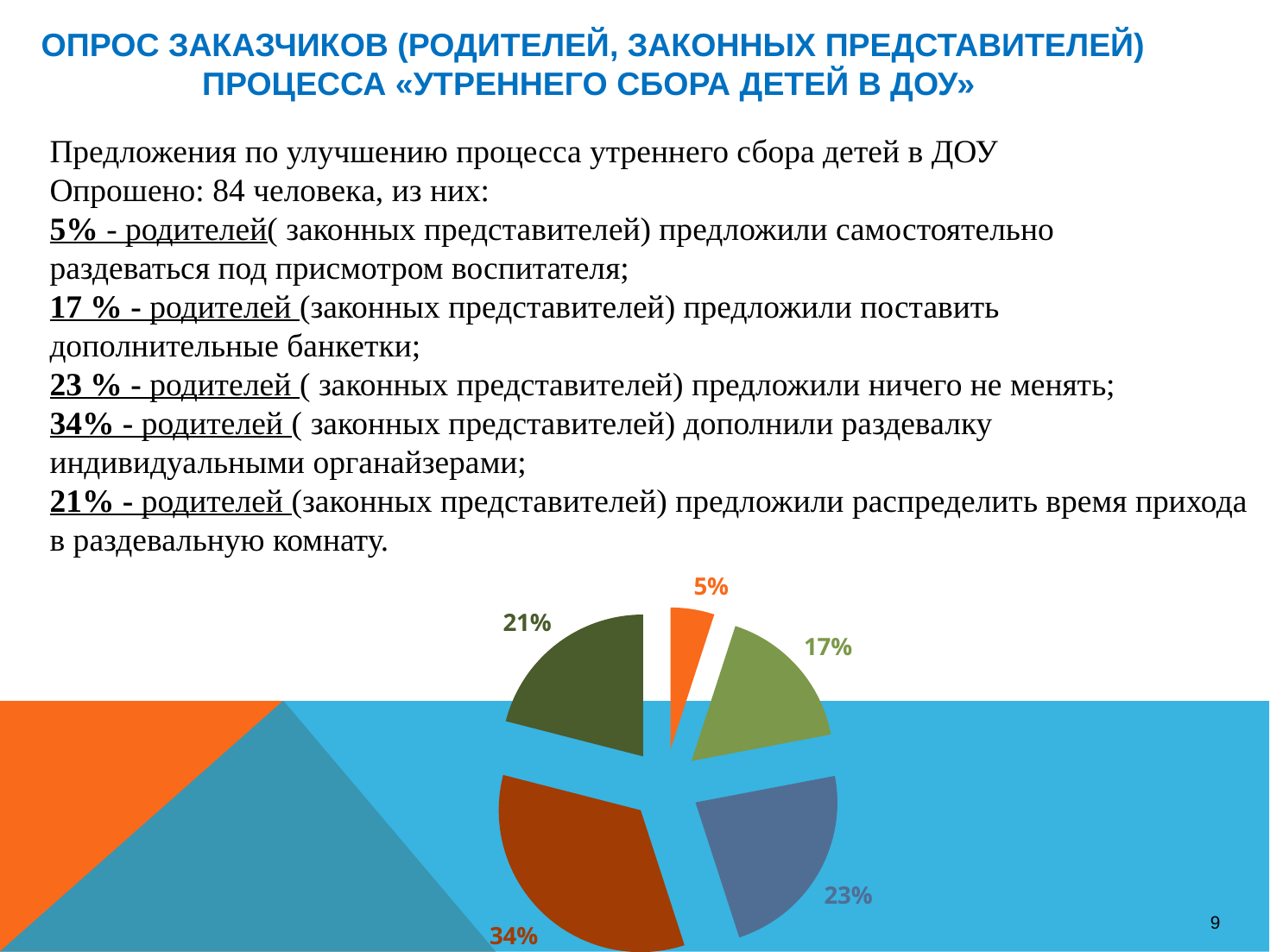
What kind of chart is shown on the slide? pie chart What is the smallest slice of the pie chart? 5% What is the largest slice of the pie chart? 34% What percentage is shown on the orange slice of the pie chart? 5% How many slices does the pie chart have? 5 Which slice is larger in the pie chart: the 23% slice or the 21% slice? 23% What percentage is shown on the blue-grey slice of the pie chart? 23% What percentage is shown on the dark red slice of the pie chart? 34% What percentage is shown on the dark green slice of the pie chart? 21% What is the combined share of the 17% and 23% slices of the pie chart? 40% What is the difference between the largest slice (34%) and the smallest slice (5%) of the pie chart? 29% According to the slide, what share of respondents proposed adding extra banquettes (банкетки)? 17%